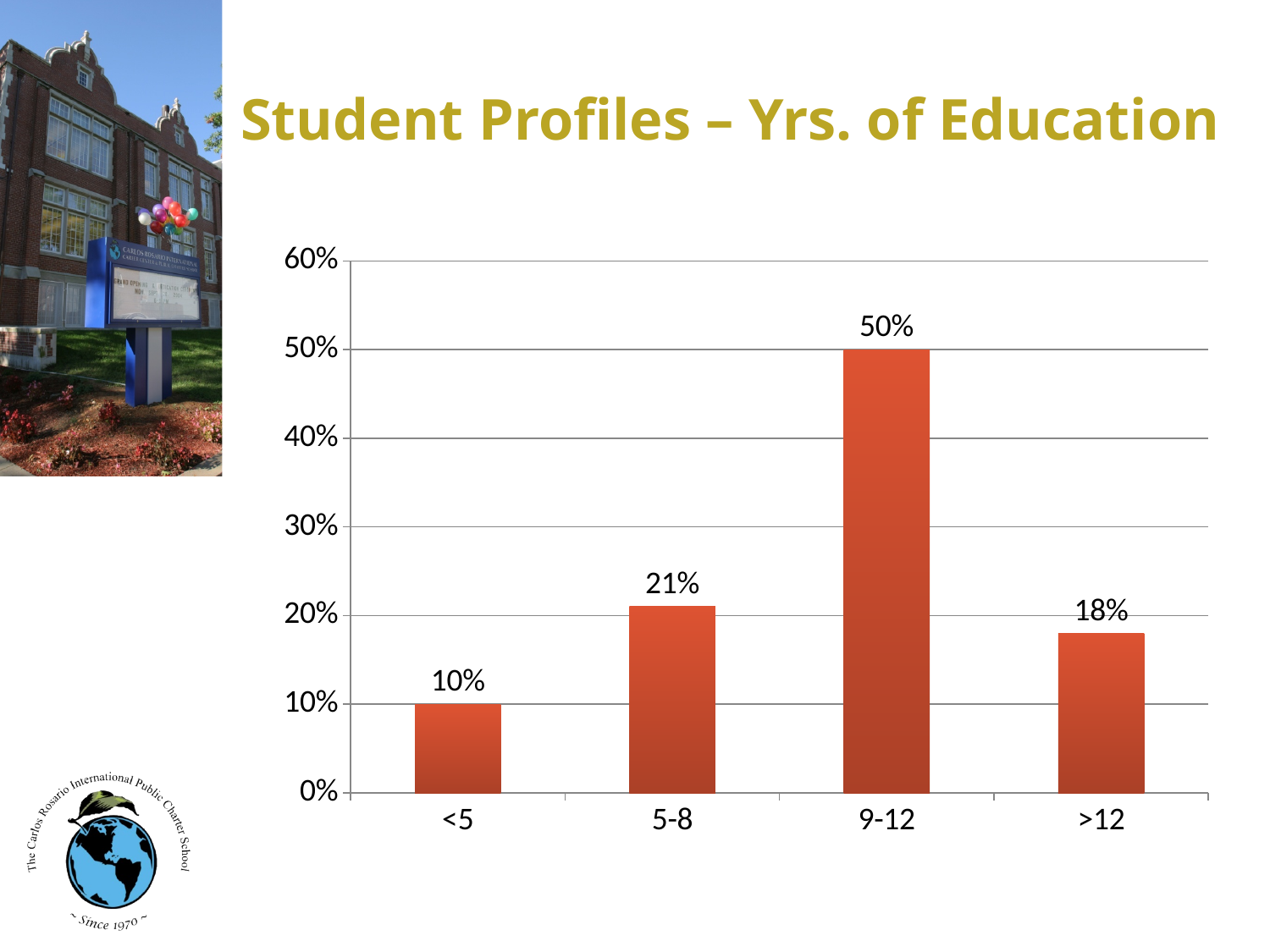
What is the difference between the 9-12 and 5-8 categories? 29% What kind of chart is shown on the slide? Bar chart How many categories are shown on the x axis? 4 What is the value for the >12 category? 18% Which years-of-education category has the lowest percentage? <5 Which is larger, the value for 5-8 or the value for >12? 5-8 What is the title of the slide containing the chart? Student Profiles – Yrs. of Education Which years-of-education category has the highest percentage? 9-12 What is the value shown for the <5 years of education category? 10% What percentage is shown for the 5-8 category? 21% What is the difference between the 5-8 and >12 categories? 3% What percentage of students have 9-12 years of education? 50%